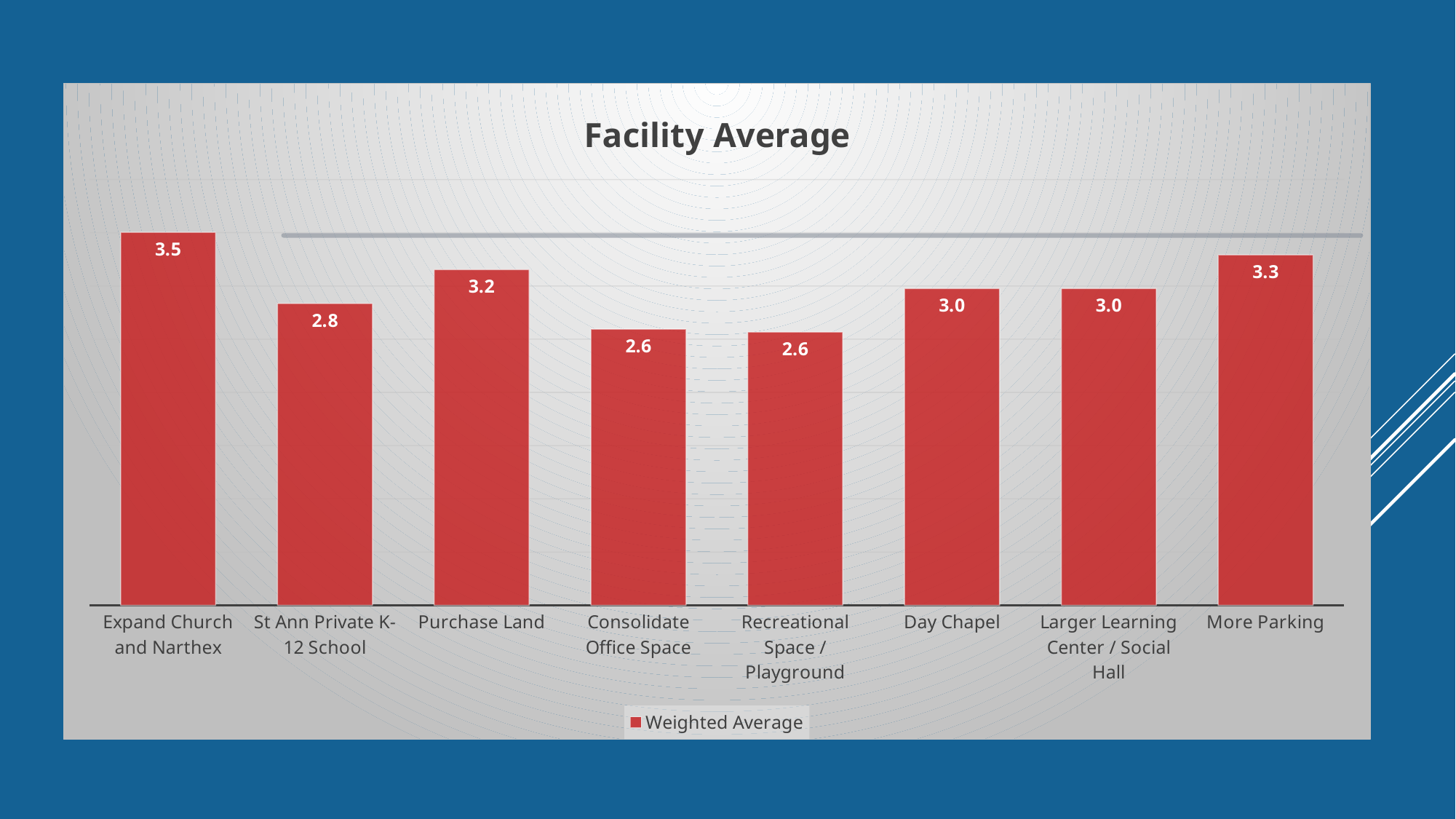
What is the weighted average for Day Chapel? 3.0 Which category has the highest weighted average? Expand Church and Narthex What kind of chart is shown on the slide? Bar chart What is the weighted average for More Parking? 3.3 Which has a larger weighted average, Purchase Land or Day Chapel? Purchase Land What is the difference between the weighted averages for More Parking and Consolidate Office Space? 0.7 What is the title of the chart? Facility Average How many categories are shown in the chart? 8 What is the weighted average for Expand Church and Narthex? 3.5 How many series does the legend list? 1 What is the difference between the weighted averages for Expand Church and Narthex and St Ann Private K-12 School? 0.7 What is the weighted average for Purchase Land? 3.2